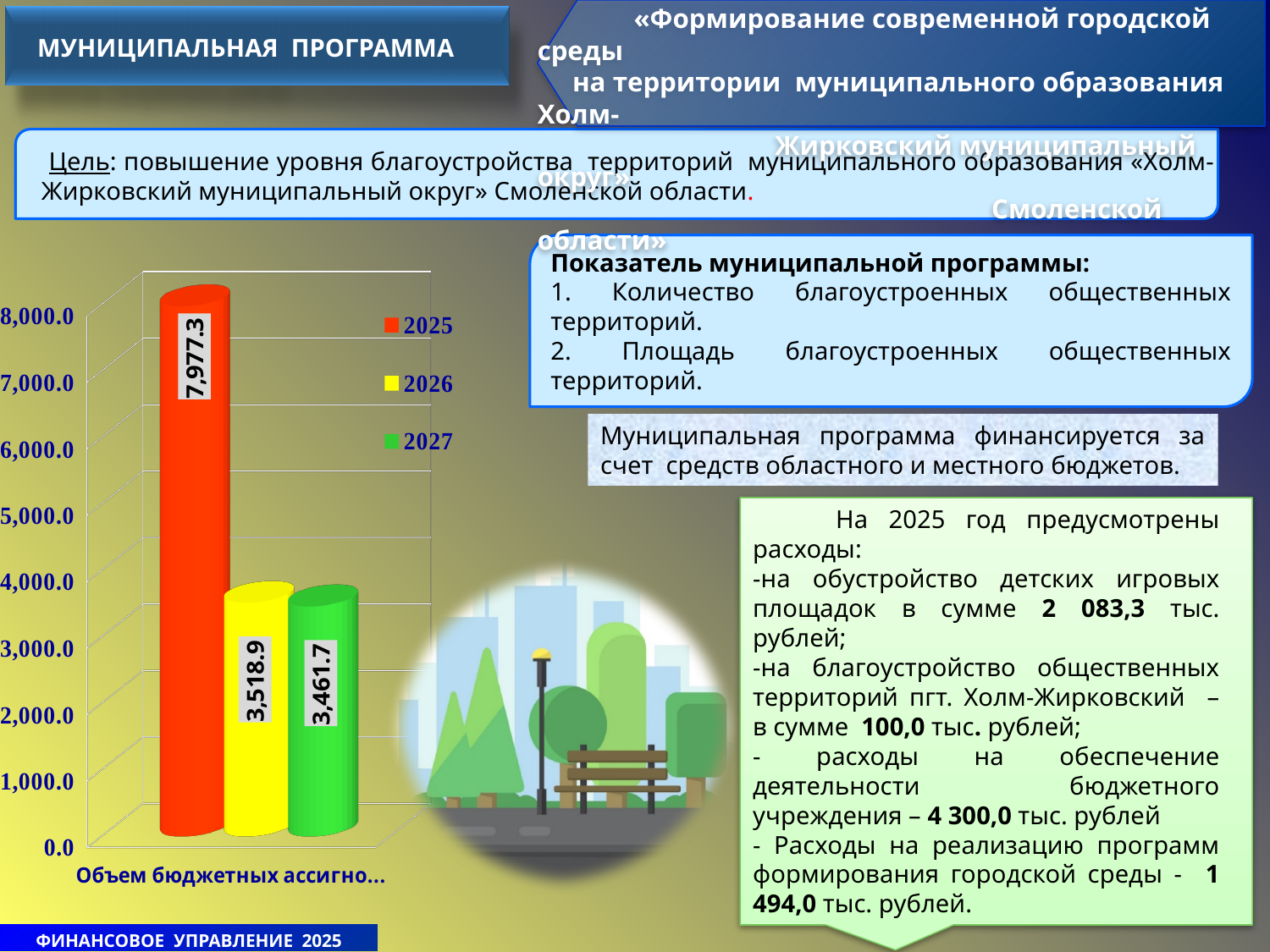
What is the value shown for the 2027 series in the bar chart? 3,461.7 Which year has the highest value in the bar chart? 2025 What is the value shown for the 2025 series in the bar chart? 7,977.3 What is the difference between the 2026 value and the 2027 value in the bar chart? 57.2 Which is larger in the bar chart, the value for 2025 or the value for 2027? 2025 What is the difference between the 2025 value and the 2026 value in the bar chart? 4,458.4 Is the value for 2026 in the bar chart greater or less than 4,000.0? less What is the value shown for the 2026 series in the bar chart? 3,518.9 What colour represents the 2026 series in the bar chart? yellow How many series does the legend of the bar chart list? 3 What kind of chart is shown on the slide? bar chart Which year has the lowest value in the bar chart? 2027